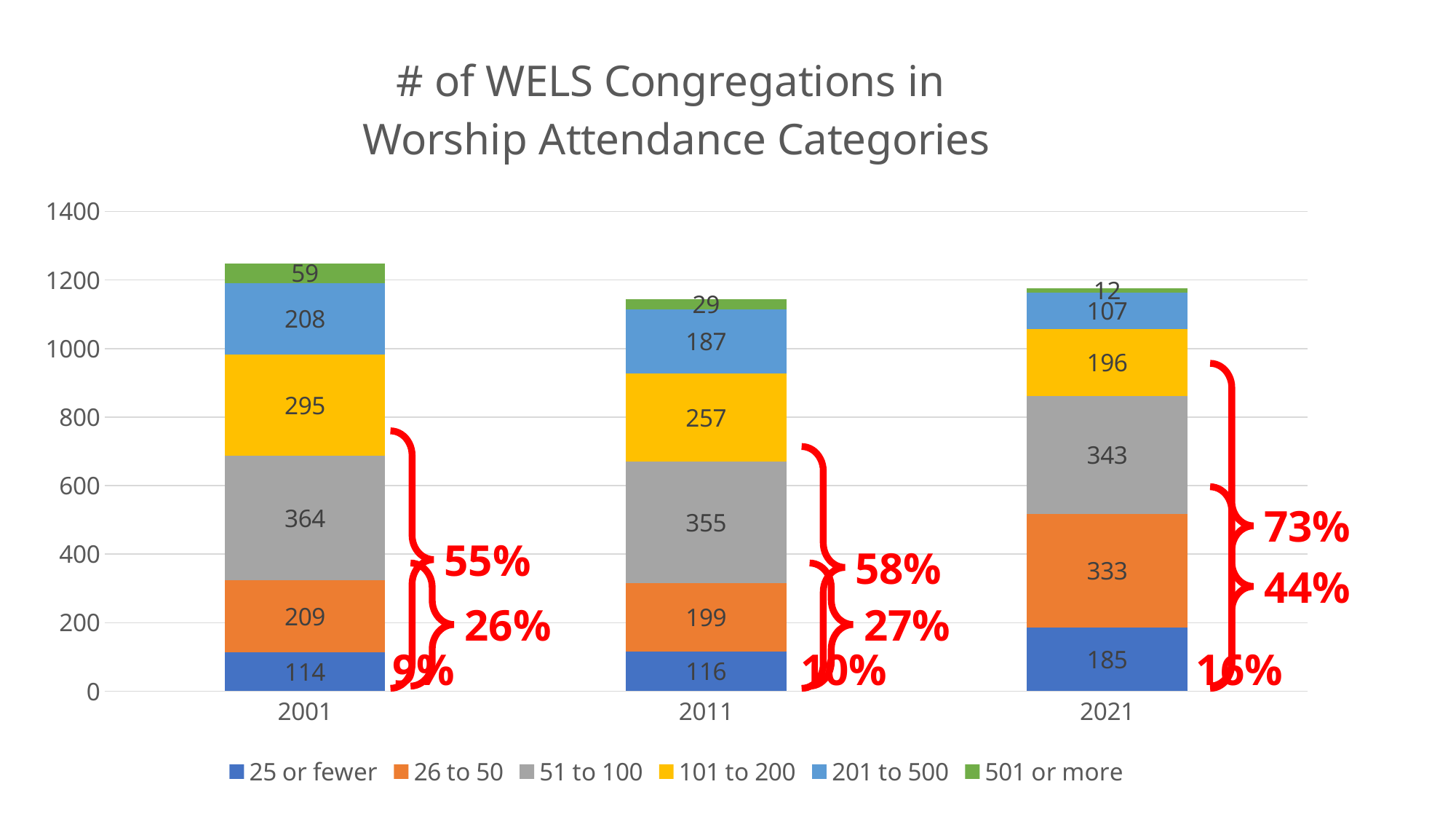
What type of chart is shown on the slide? stacked bar chart What is the difference between the '501 or more' values in 2001 and 2011? 30 Which year has the lowest value for the '101 to 200' category? 2021 Does the '201 to 500' value fall or rise from 2001 to 2021? fall How many years are shown on the x axis? 3 Which year has the highest value for the '26 to 50' category? 2021 What is the value for the '25 or fewer' category in 2021? 185 What is the value for the '51 to 100' category in 2001? 364 What is the total of the stacked bar for 2011? 1143 How many series does the legend list? 6 What is the value for the '201 to 500' category in 2011? 187 What is the value for the '501 or more' category in 2021? 12